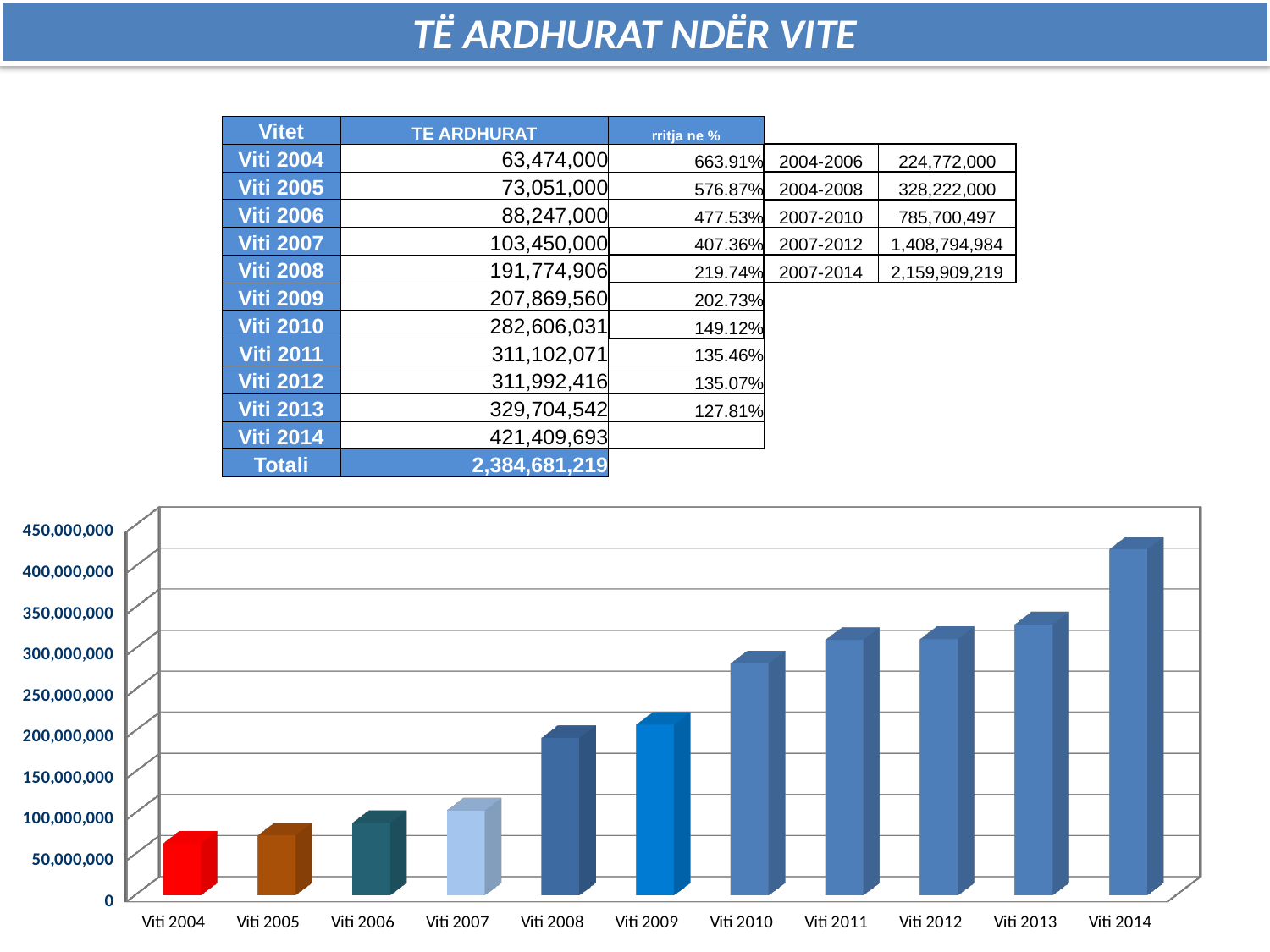
Which is larger, the value for Viti 2009 or the value for Viti 2008? Viti 2009 What kind of chart is shown on the slide? bar chart What is the title shown at the top of the slide? TË ARDHURAT NDËR VITE According to the table, what is the value (TE ARDHURAT) for Viti 2004? 63,474,000 How many years (categories) are plotted on the x axis of the chart? 11 Is the value for Viti 2010 greater or less than 250,000,000? greater According to the table, what is the value (TE ARDHURAT) for Viti 2014? 421,409,693 Is the value for Viti 2014 greater or less than 400,000,000? greater Which year has the lowest bar in the chart? Viti 2004 Do the values generally rise or fall from Viti 2004 to Viti 2014? rise Which year has the highest bar in the chart? Viti 2014 Is the value for Viti 2007 greater or less than 150,000,000? less